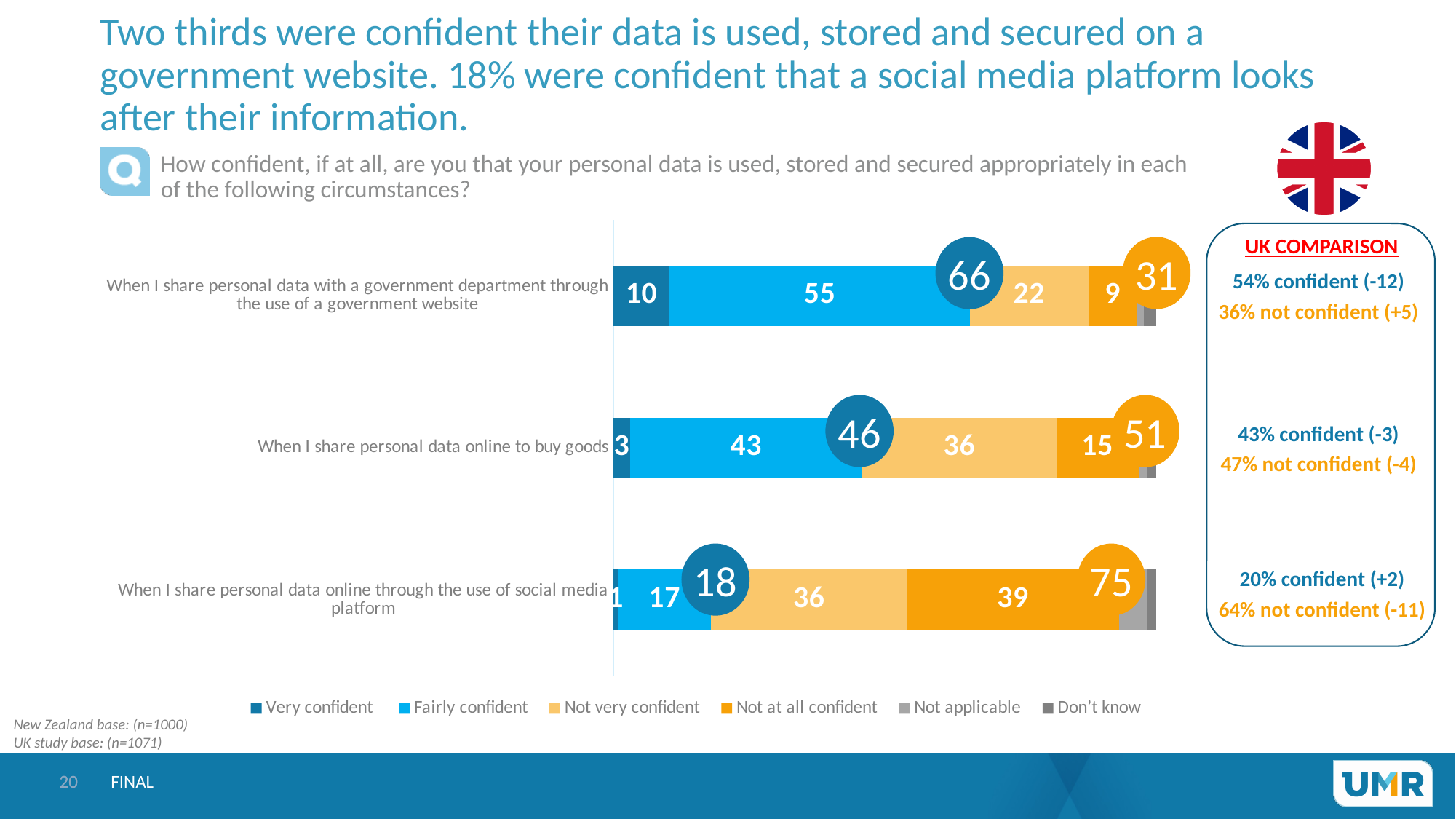
What is the 'Not at all confident' value for sharing personal data online through the use of a social media platform? 39 How many series does the legend list? 6 How many circumstances (categories) are plotted in the chart? 3 What is the 'Very confident' value for sharing personal data online to buy goods? 3 What is the 'Fairly confident' value for sharing personal data with a government department through a government website? 55 What is the 'Not very confident' value for sharing personal data online to buy goods? 36 What is the difference between the 'Not at all confident' values for the social media platform and the government website? 30 What is the combined confident (Very confident plus Fairly confident) figure shown in the blue circle for sharing personal data online to buy goods? 46 What kind of chart is shown on the slide? Stacked bar chart Is the 'Not very confident' value larger for the government website or for buying goods online? Buying goods online Which circumstance has the lowest 'Very confident' value? When I share personal data online through the use of social media platform Which circumstance has the highest 'Fairly confident' value? When I share personal data with a government department through the use of a government website